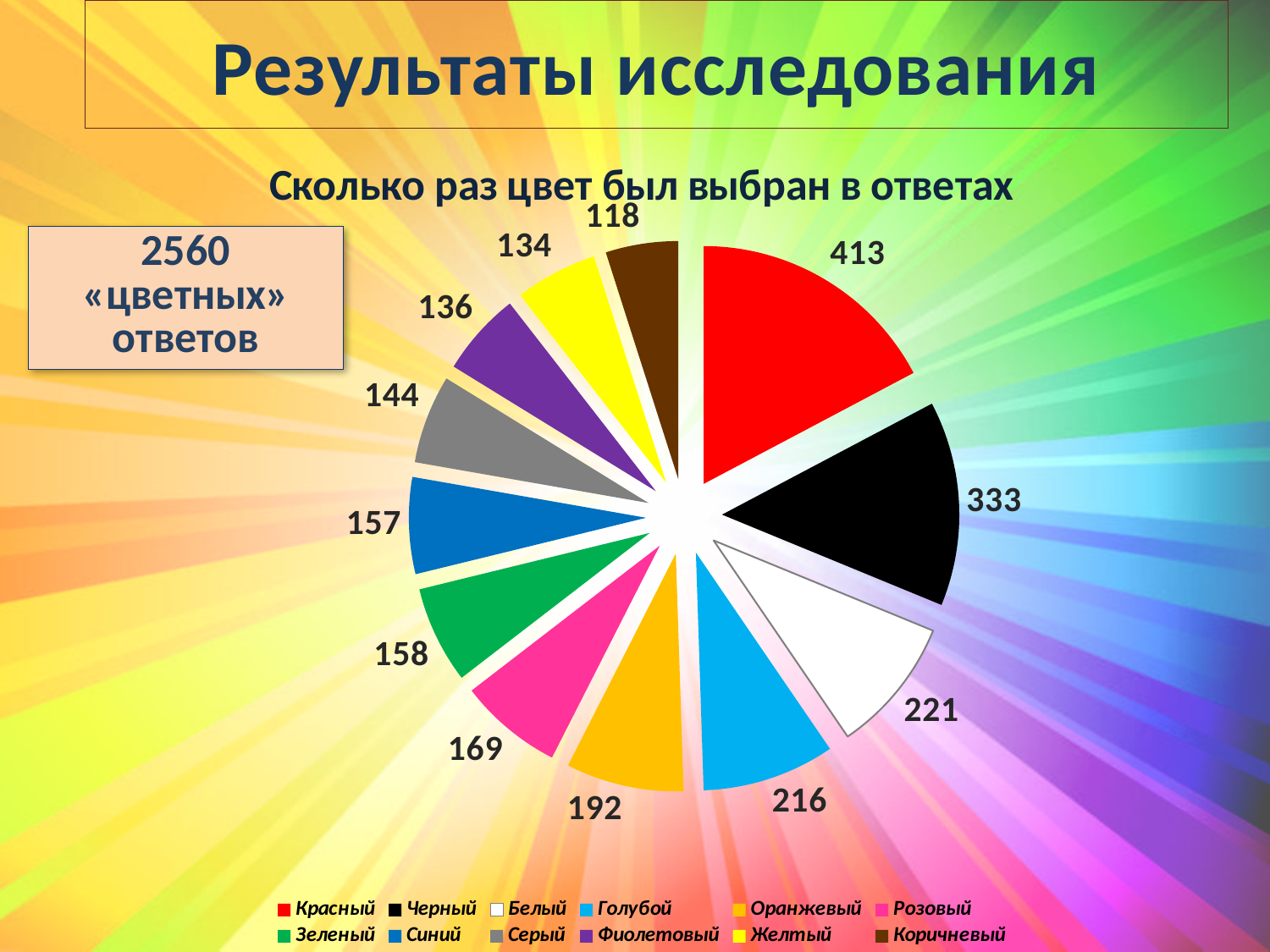
What is the title of the chart? Сколько раз цвет был выбран в ответах How many times was Красный chosen according to the chart? 413 What is the value for Белый in the chart? 221 Which colour has the smallest slice in the pie chart? Коричневый What is the value for Коричневый in the chart? 118 What is the difference between the values for Белый and Голубой? 5 What kind of chart is shown on the slide? pie chart Which colour has the largest slice in the pie chart? Красный What is the value for Фиолетовый in the chart? 136 What is the difference between the values for Красный and Черный? 80 How many slices does the pie chart have? 12 Which has a larger value, Голубой or Оранжевый? Голубой